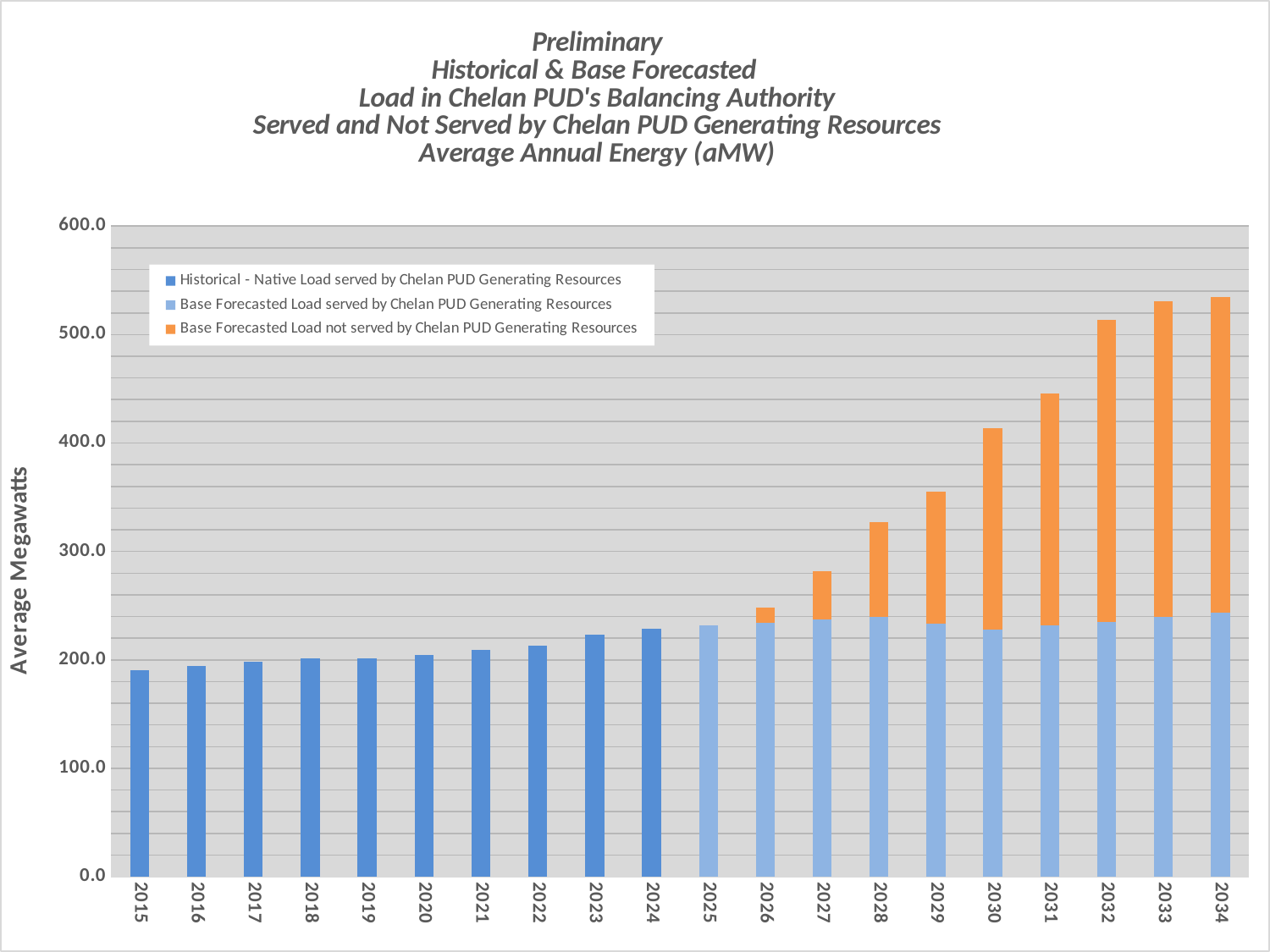
Is the total value for 2015 greater or less than 200? less Is the total value for 2030 greater or less than 400? greater How many series does the legend list? 3 Do the total bar heights generally rise or fall from 2015 to 2034? rise Which series is shown in orange? Base Forecasted Load not served by Chelan PUD Generating Resources Is the total value for 2034 greater or less than 500? greater Which has the larger total bar, 2031 or 2032? 2032 What kind of chart is shown on the slide? bar chart How many years are shown along the x axis? 20 Which year has the lowest total bar? 2015 What is the label on the vertical axis? Average Megawatts